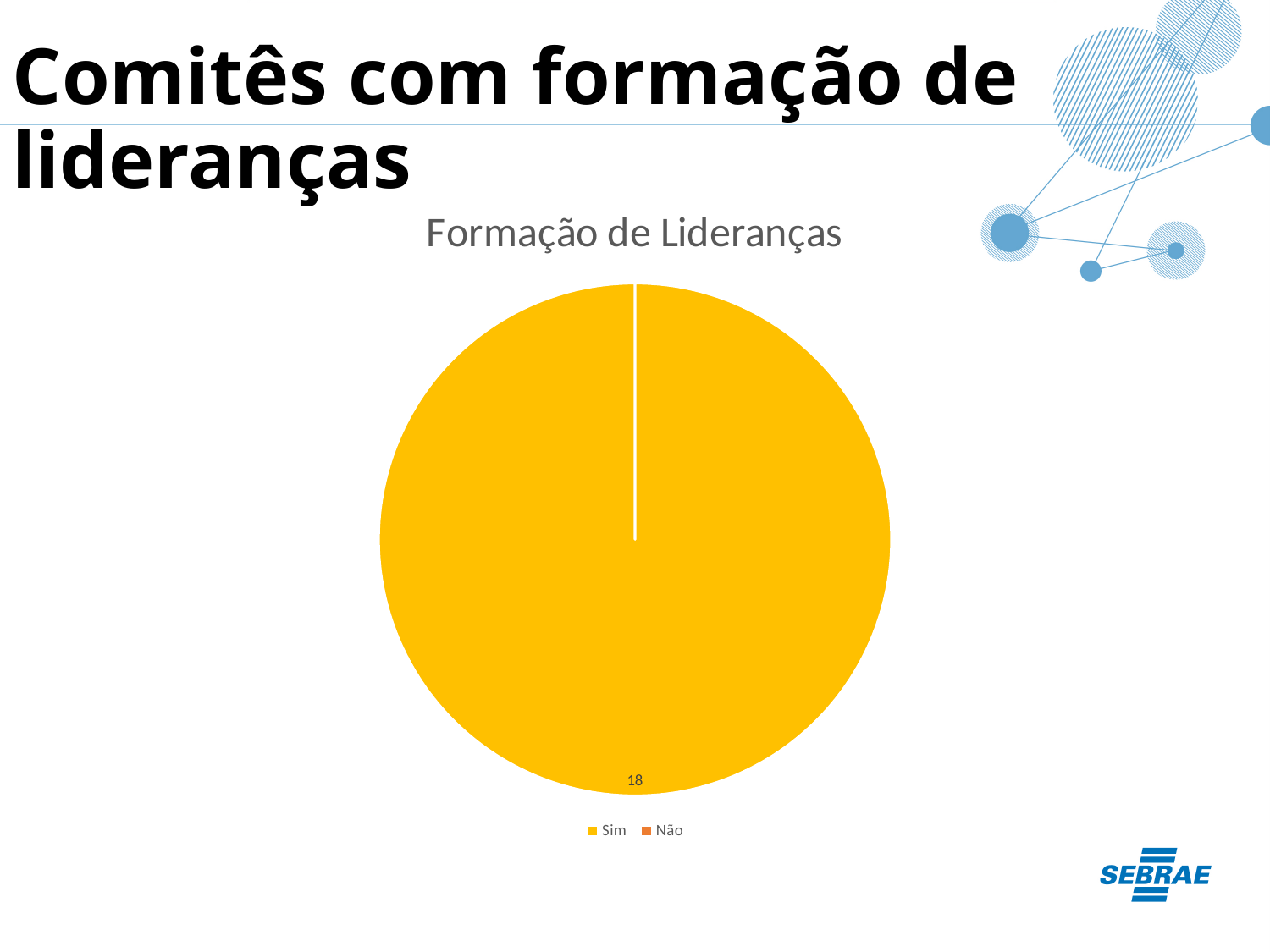
Which category has the smallest slice of the pie? Não Is the value for Sim greater or less than 10? greater What is the value for the Sim category? 18 Which category has the largest slice of the pie? Sim How many entries does the chart's legend list? 2 What colour represents the Sim category in the chart? yellow What is the title of the chart? Formação de Lideranças What kind of chart is shown on the slide? pie chart Which is larger, the slice for Sim or the slice for Não? Sim What value is printed on the pie chart? 18